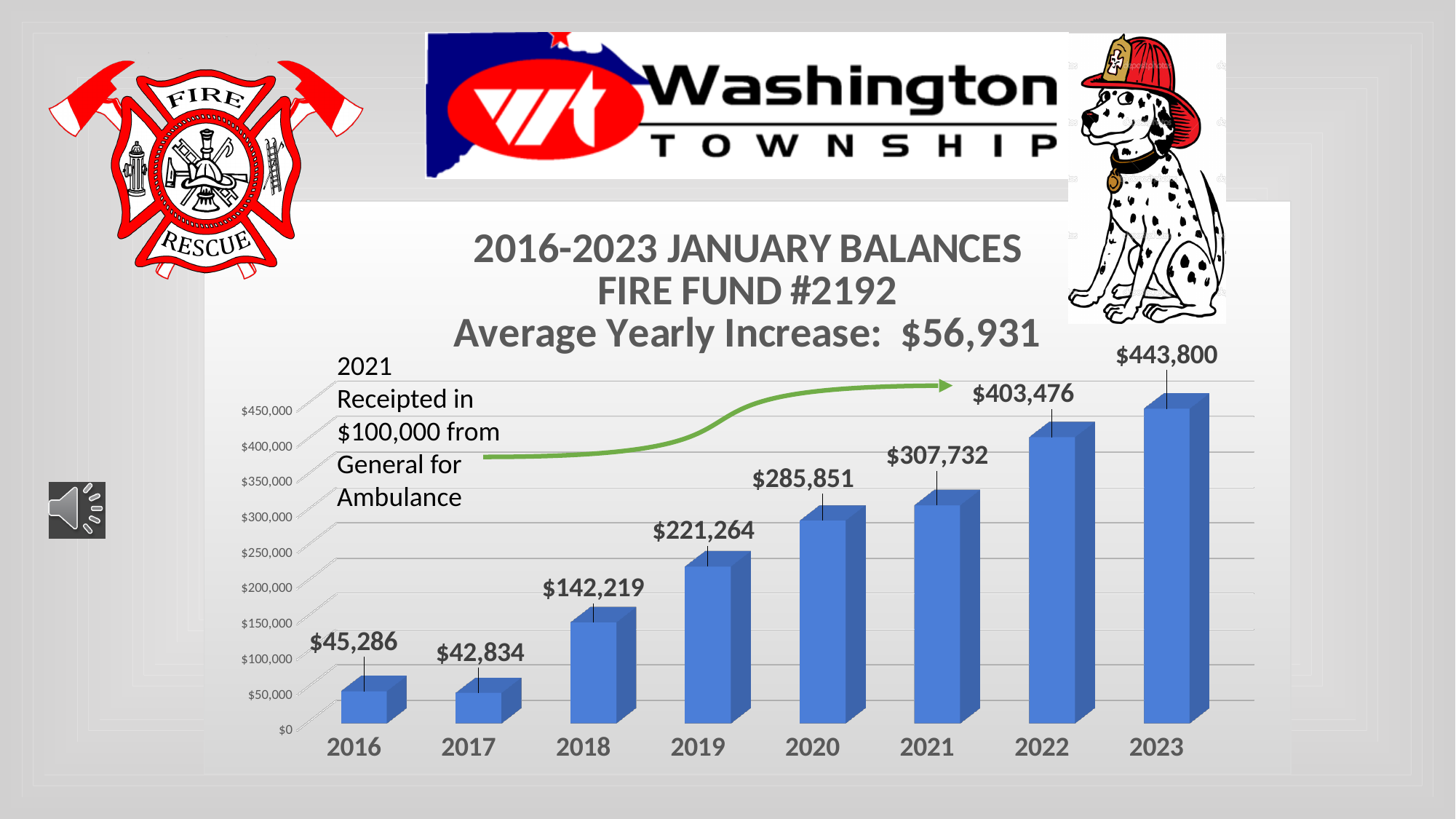
What is the January balance for 2022? $403,476 How many years are shown on the chart? 8 Which year has the highest January balance? 2023 What is the January balance for 2019? $221,264 Is the January balance for 2020 greater or less than $250,000? greater Which is larger, the January balance for 2020 or for 2021? 2021 What kind of chart is shown on the slide? bar chart What is the January balance for 2016? $45,286 Which year has the lowest January balance? 2017 What average yearly increase is stated in the chart title? $56,931 What is the difference between the 2023 and 2022 January balances? $40,324 What is the difference between the 2018 and 2017 January balances? $99,385